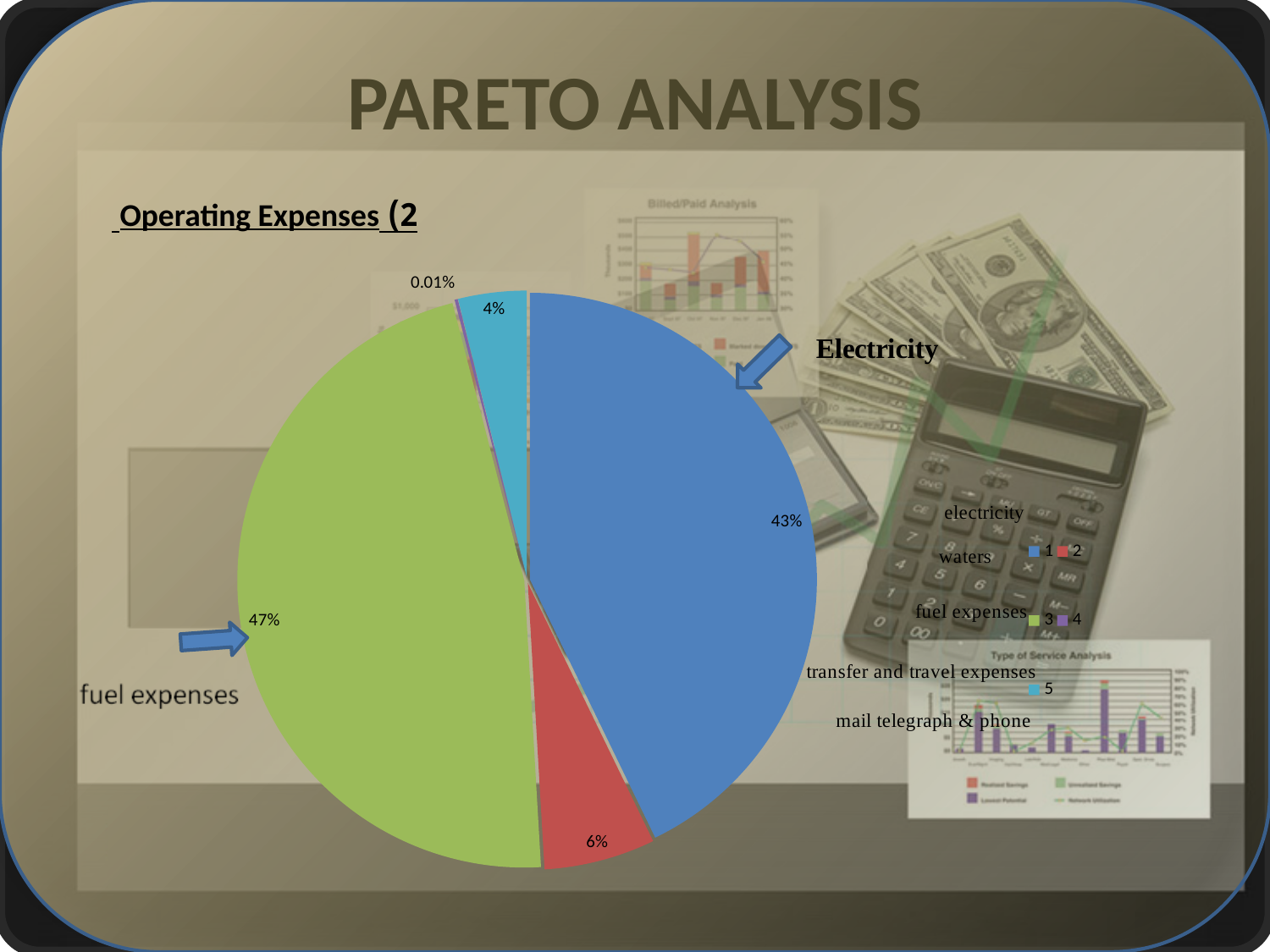
What is the title of the chart? Operating Expenses (2 What is the value of the red slice in the pie chart? 6% What percentage of the pie does the fuel expenses slice represent? 47% Which is larger, the Electricity slice or the fuel expenses slice? fuel expenses How many entries does the legend list? 5 How many slices does the pie chart have? 5 What type of chart is shown on the slide? pie chart What percentage of the pie does the Electricity slice represent? 43% What is the value of the smallest slice in the pie chart? 0.01% What is the difference in percentage points between the fuel expenses slice and the Electricity slice? 4 Which category has the largest slice of the pie? fuel expenses What colour is the Electricity slice? blue